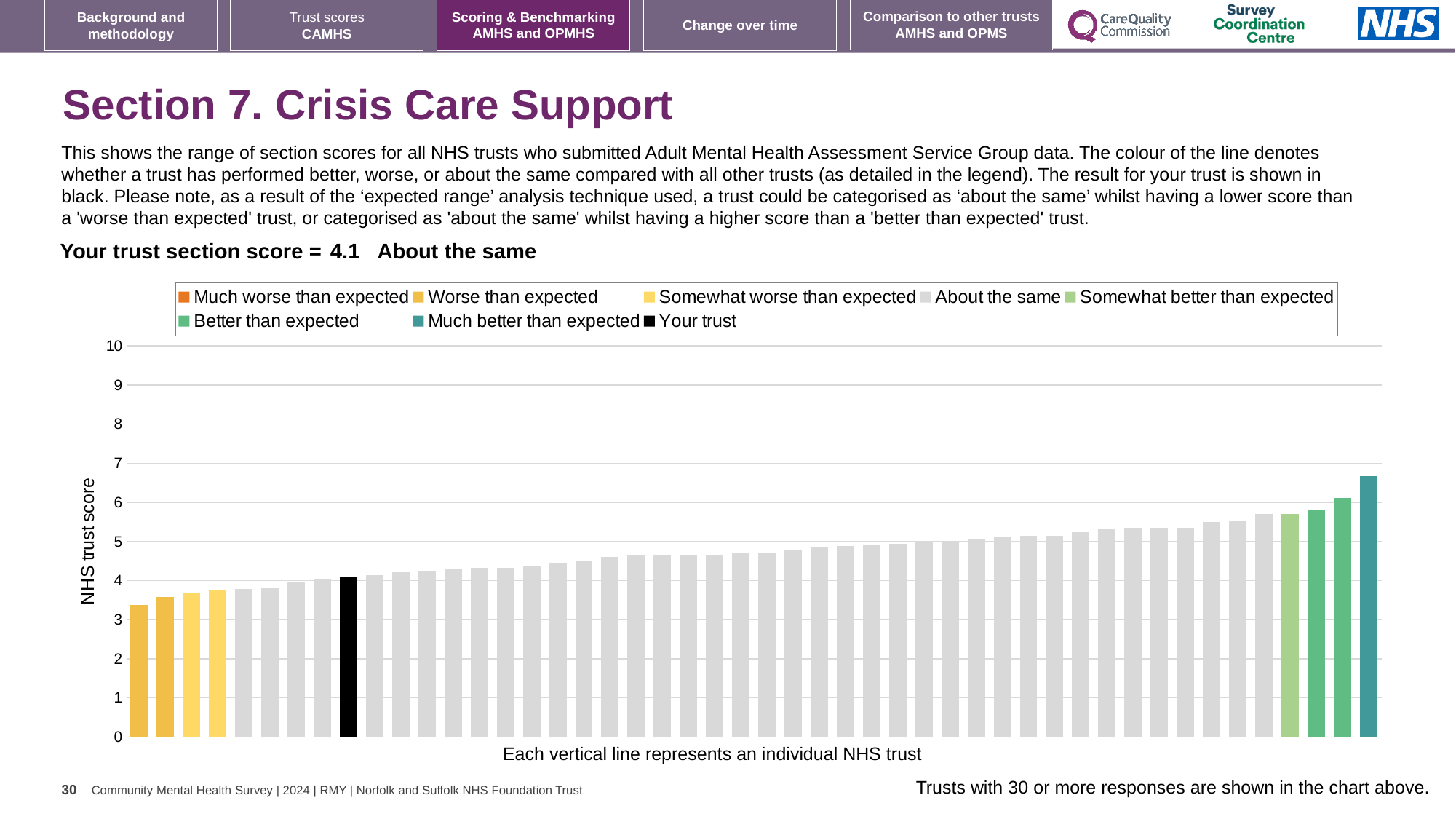
Is the value for your trust greater or less than 5? less What is the label on the y axis of the chart? NHS trust score Is the value for your trust (the black bar) greater or less than 4? greater What is the section score for your trust? 4.1 Which performance category is your trust placed in for Crisis Care Support? About the same Is the value of the shortest bar (the leftmost trust) greater or less than 4? less Do the trust scores rise or fall moving from left to right along the x axis? rise How many bars are coloured as 'Much better than expected' (teal)? 1 What kind of chart is shown on the slide? bar chart How many entries does the chart legend list? 8 What colour is the bar representing your trust? black